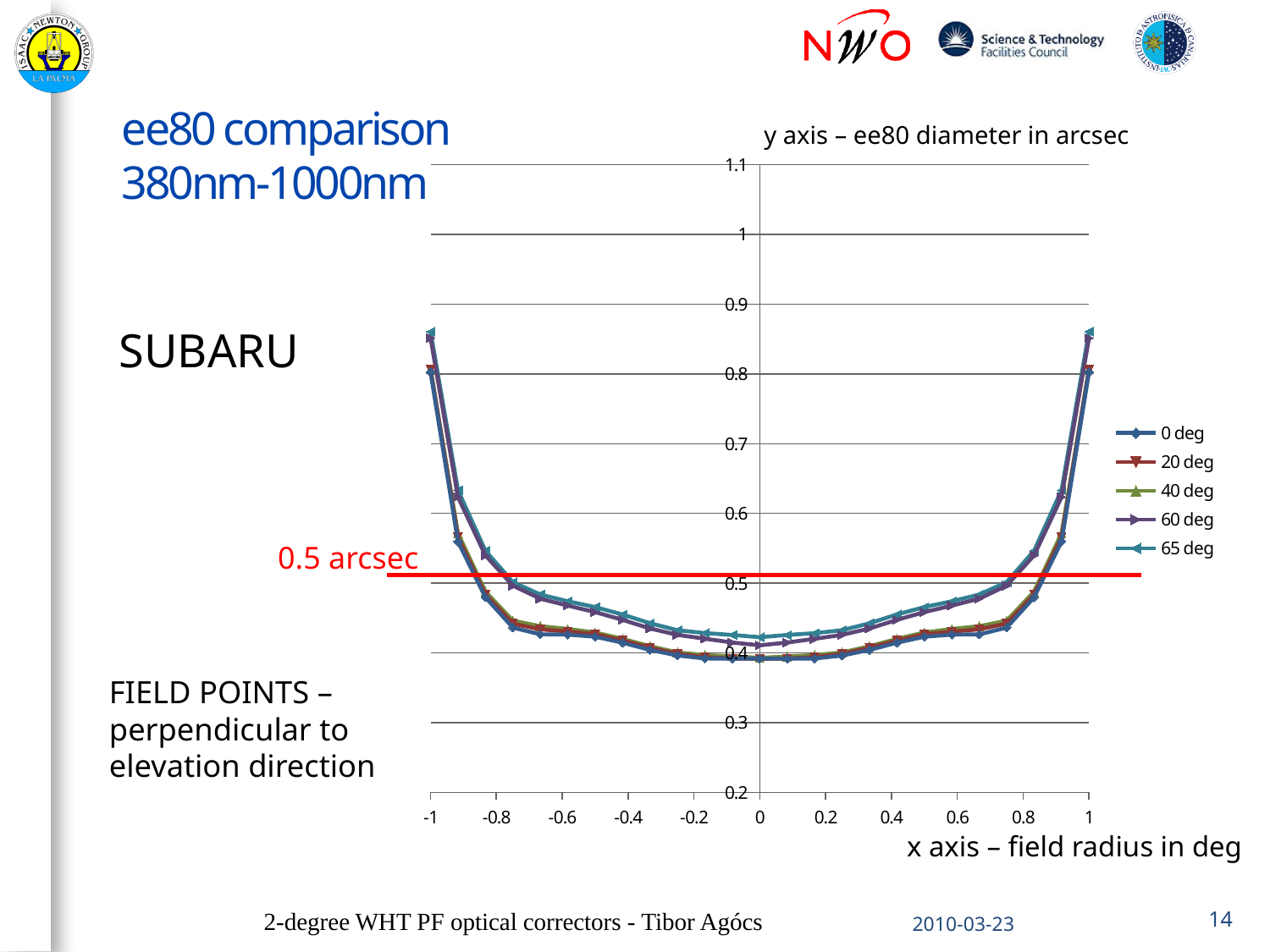
At x = 0, which series has the larger value: 60 deg or 0 deg? 60 deg Do the values rise or fall as x goes from -1 to 0? fall Is the value for the 65 deg series at x = -1 greater or less than 0.8? greater What does the y axis of the chart represent, according to the slide? ee80 diameter in arcsec Is the value for the 65 deg series at x = 0 greater or less than 0.5? less How many labelled tick marks are on the x axis? 11 How many series does the legend list? 5 Is the value for the 0 deg series at x = 1 greater or less than 0.7? greater Do the values rise or fall as x goes from 0 to 1? rise What kind of chart is shown on the slide? line chart What are the series names listed in the legend? 0 deg, 20 deg, 40 deg, 60 deg, 65 deg